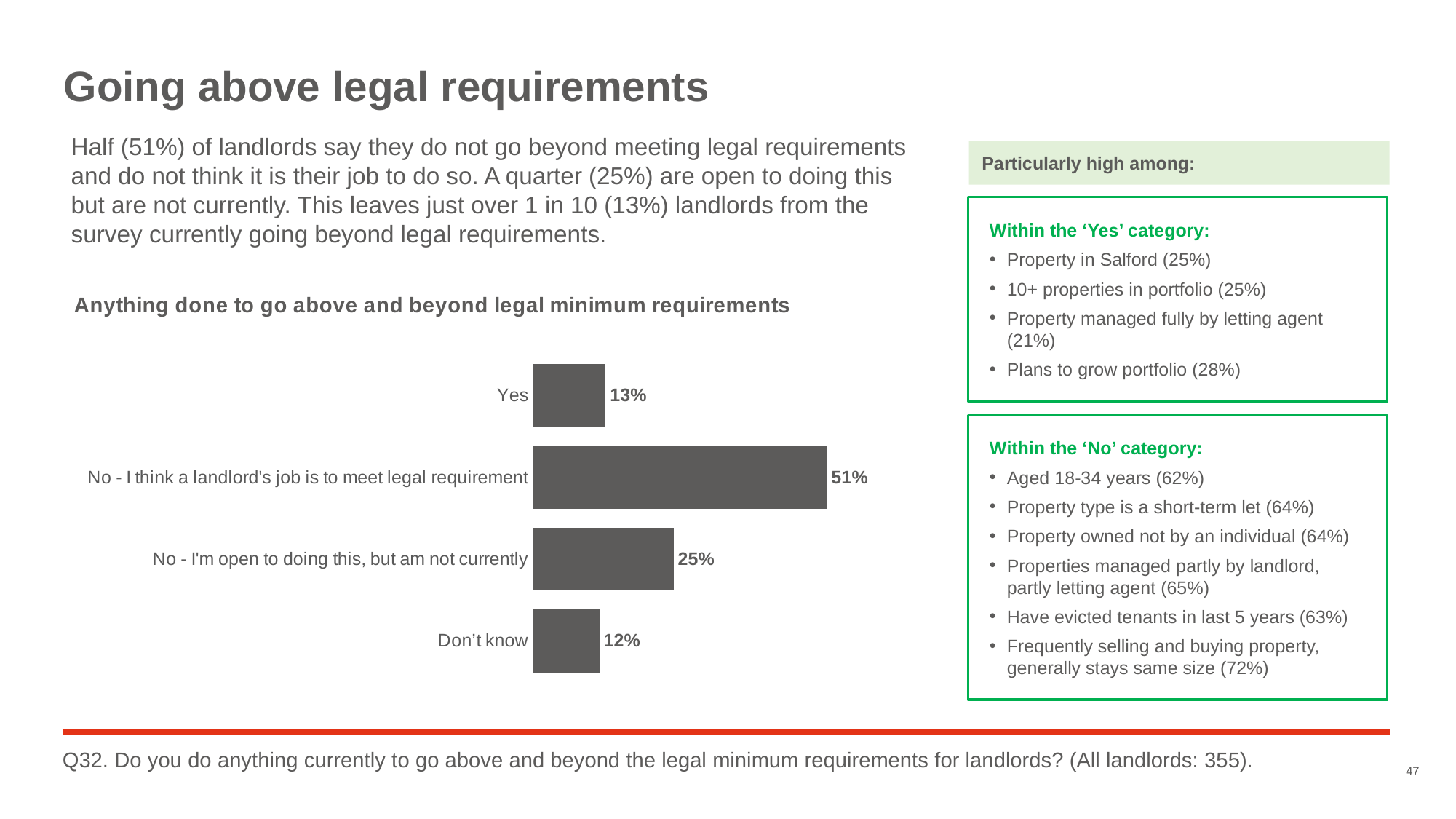
What percentage of landlords answered 'Yes' to doing anything above and beyond legal minimum requirements? 13% What is the value for 'No - I think a landlord's job is to meet legal requirement'? 51% What type of chart is shown on the slide? Bar chart Which category has the highest value in the chart? No - I think a landlord's job is to meet legal requirement Which is larger: the value for 'Yes' or the value for 'No - I'm open to doing this, but am not currently'? No - I'm open to doing this, but am not currently Which category has the lowest value in the chart? Don't know What percentage of landlords answered 'Don't know'? 12% What is the difference between the 'No - I think a landlord's job is to meet legal requirement' value and the 'No - I'm open to doing this, but am not currently' value? 26 percentage points What is the title of the chart? Anything done to go above and beyond legal minimum requirements How many categories are shown in the chart? 4 What is the value for 'No - I'm open to doing this, but am not currently'? 25% What is the difference between the 'Yes' value and the 'Don't know' value? 1 percentage point